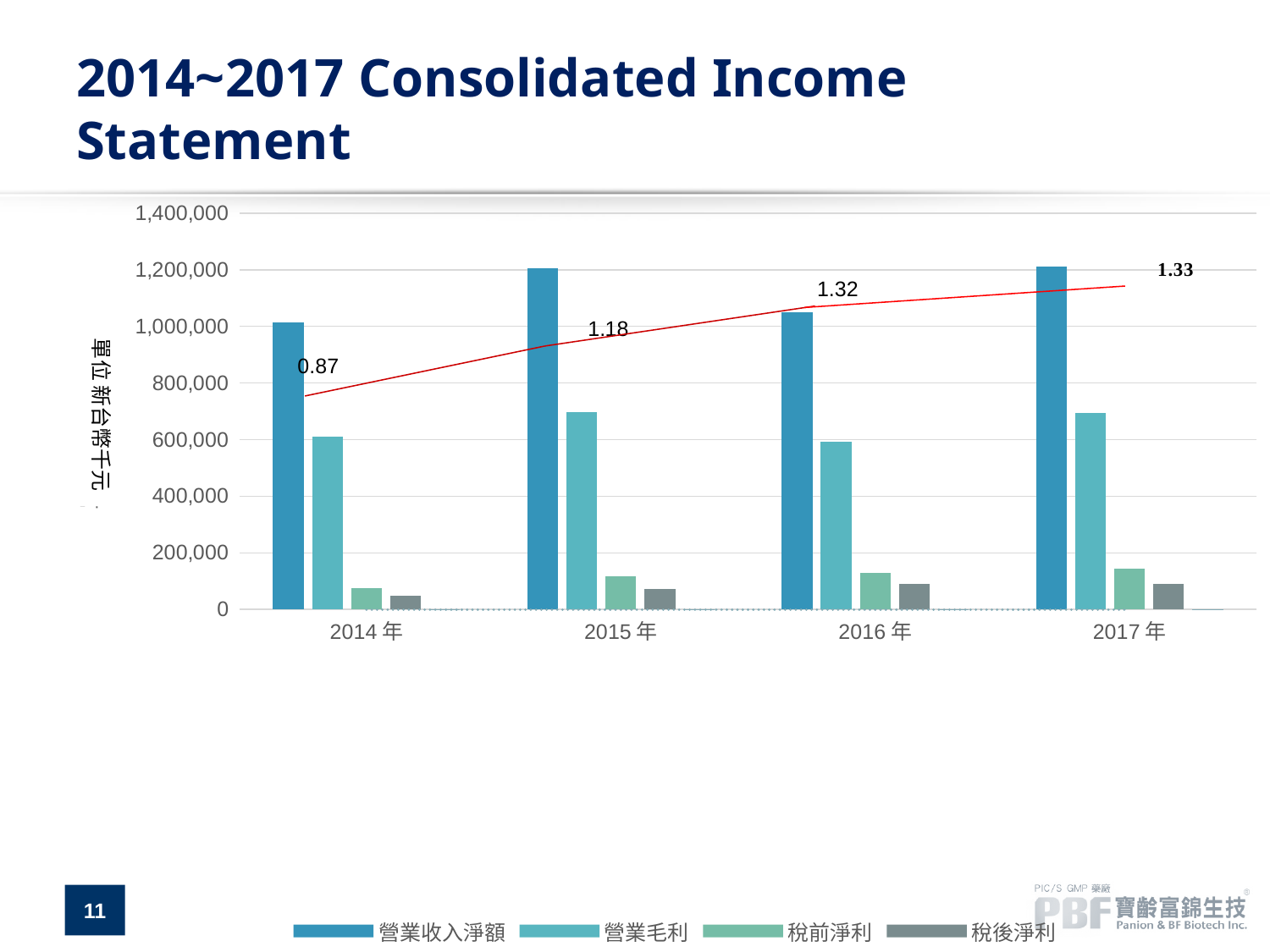
Is the 營業毛利 bar for 2015 年 greater or less than 600,000? greater In which year does the red line have its lowest labelled value? 2014 年 What value is labelled on the red line for 2017 年? 1.33 In which year does the red line reach its highest labelled value? 2017 年 Is the 營業收入淨額 bar for 2014 年 greater or less than 800,000? greater What value is labelled on the red line for 2016 年? 1.32 What value is labelled on the red line for 2014 年? 0.87 Does the red line rise or fall from 2014 年 to 2017 年? rise How many series does the legend list? 4 Which year has the larger 營業收入淨額 bar, 2014 年 or 2015 年? 2015 年 What is the difference between the red line values for 2016 年 and 2014 年? 0.45 How many years are shown on the x axis? 4